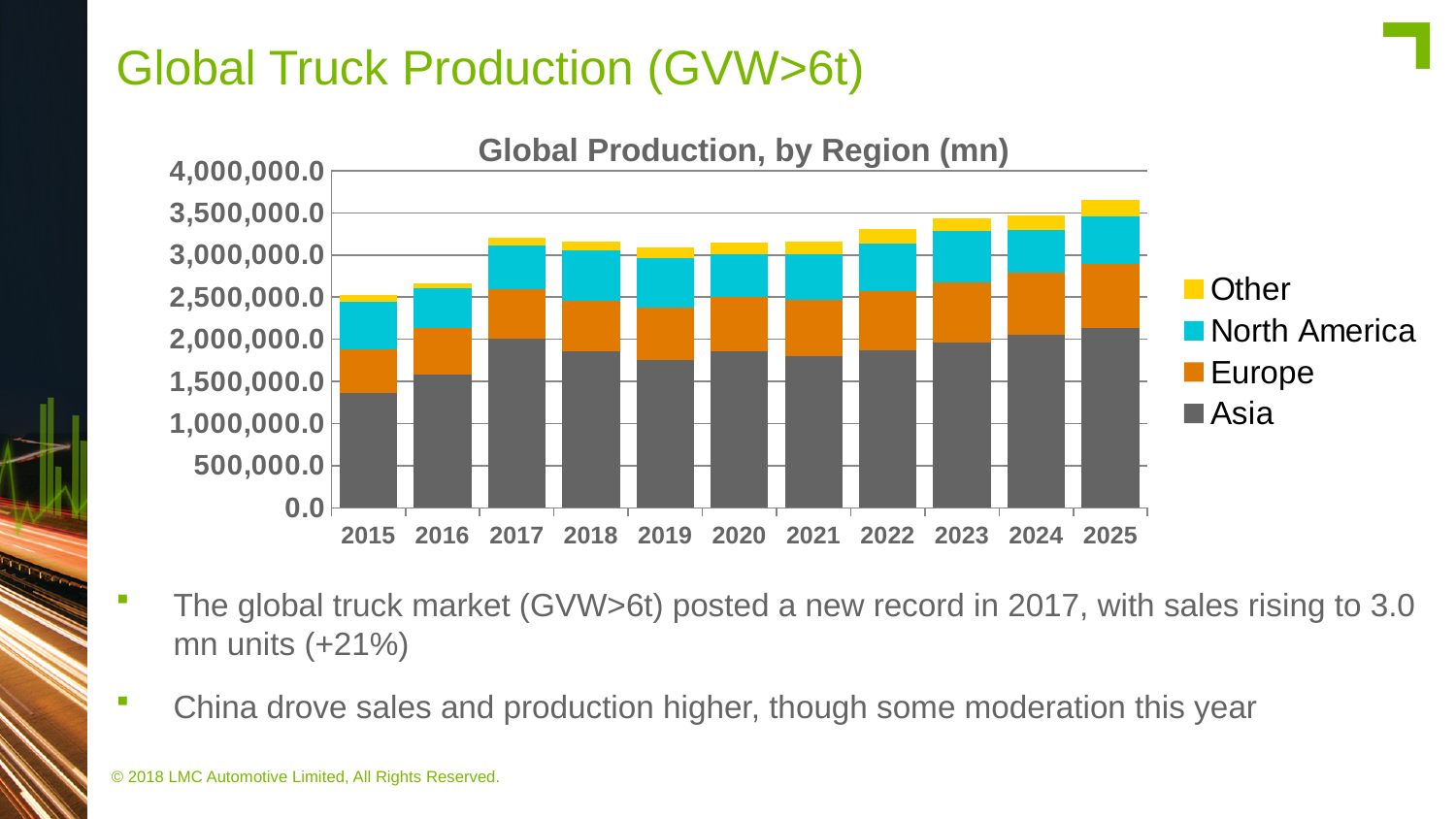
Which year has the larger total production, 2016 or 2017? 2017 Is the total production for 2025 greater or less than 3,500,000.0? greater Which year has the lowest total production? 2015 Is the Asia value for 2015 greater or less than 1,500,000.0? less What is the title of the chart? Global Production, by Region (mn) How many series does the legend list? 4 Which region forms the largest segment of each bar? Asia Which year has the highest total production? 2025 How many years are shown on the x axis? 11 Is the total production for 2016 greater or less than 3,000,000.0? less What kind of chart is shown on the slide? Stacked bar chart